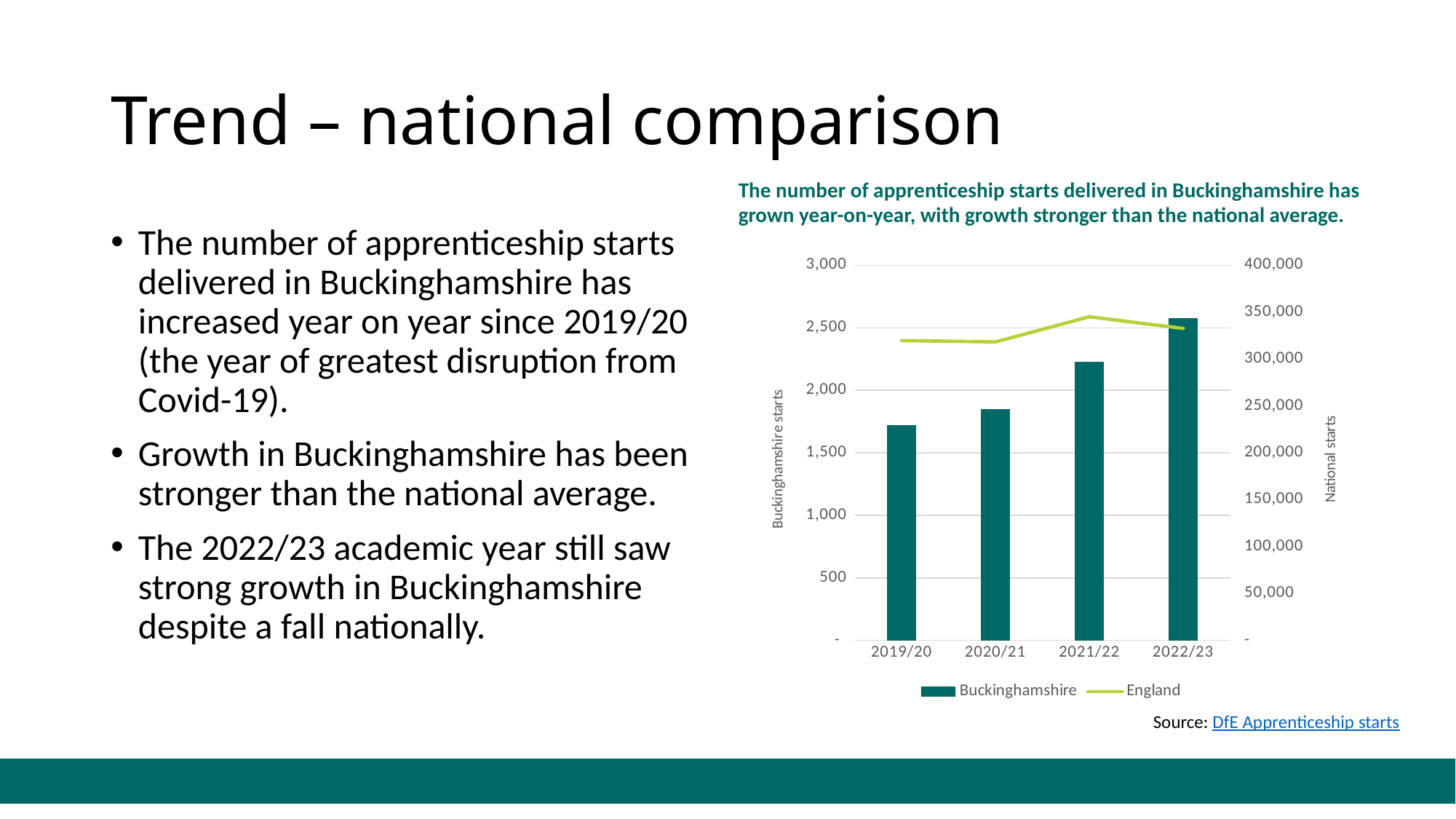
What kind of chart is shown on the slide? A bar chart combined with a line Is the value for Buckinghamshire starts in 2019/20 greater or less than 2,000? less How many series does the chart legend list? 2 How many academic years are shown on the x axis of the chart? 4 Which is larger for Buckinghamshire starts: 2020/21 or 2021/22? 2021/22 Do the Buckinghamshire starts rise or fall from 2019/20 to 2022/23? Rise Which academic year has the highest number of Buckinghamshire apprenticeship starts? 2022/23 Which academic year has the lowest number of Buckinghamshire apprenticeship starts? 2019/20 Which series are listed in the chart legend? Buckinghamshire and England What is the label on the right-hand vertical axis of the chart? National starts Is the value for England starts in 2021/22 greater or less than 300,000? greater Is the value for Buckinghamshire starts in 2022/23 greater or less than 2,500? greater